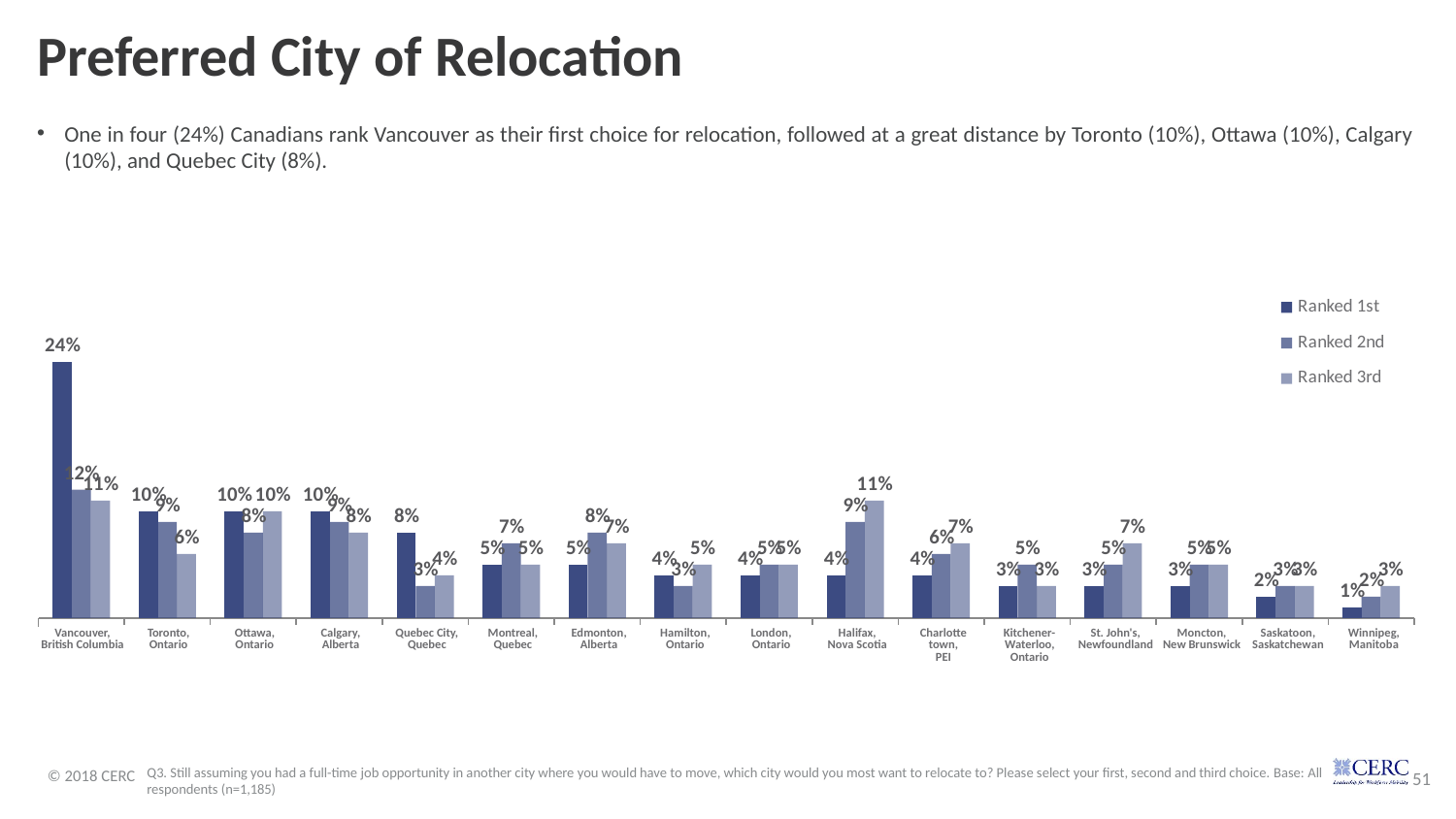
What is the difference between the Ranked 1st values for Vancouver, British Columbia and Toronto, Ontario? 14 percentage points Which city has the highest Ranked 1st value? Vancouver, British Columbia What is the Ranked 2nd value for Edmonton, Alberta? 8% What is the Ranked 3rd value for Halifax, Nova Scotia? 11% How many cities are shown on the chart? 16 What percentage of respondents ranked Vancouver, British Columbia as their 1st choice? 24% How many series does the legend list? 3 For Halifax, Nova Scotia, which is larger: the Ranked 1st value or the Ranked 3rd value? Ranked 3rd What is the Ranked 1st value for Quebec City, Quebec? 8% What type of chart is shown on the slide? Bar chart Which city has the lowest Ranked 1st value? Winnipeg, Manitoba Do the Ranked 1st values generally rise or fall from left to right across the cities? Fall